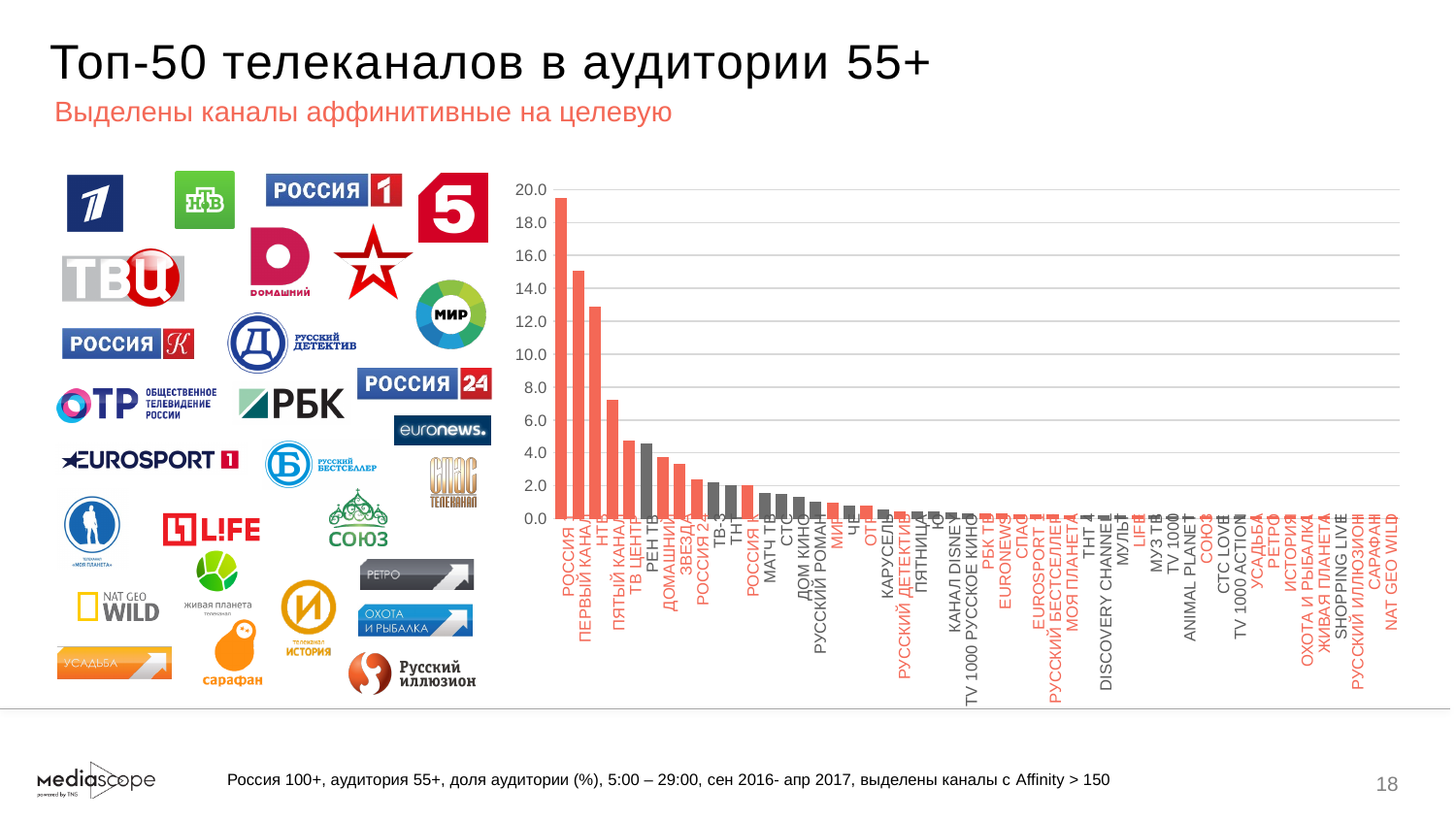
Is the value for РОССИЯ 1 greater or less than 18.0? greater How many channels are plotted in the chart? 50 What is the title of the slide? Топ-50 телеканалов в аудитории 55+ Is the value for ПЯТЫЙ КАНАЛ greater or less than 6.0? greater Do the values rise or fall moving from left to right along the x axis? fall Which channel has the highest value in the chart? РОССИЯ 1 Is the value for НТВ greater or less than 14.0? less Which has a larger value, ТВ ЦЕНТР or ЗВЕЗДА? ТВ ЦЕНТР What kind of chart is shown on the slide? bar chart Which has a larger value, ПЕРВЫЙ КАНАЛ or НТВ? ПЕРВЫЙ КАНАЛ